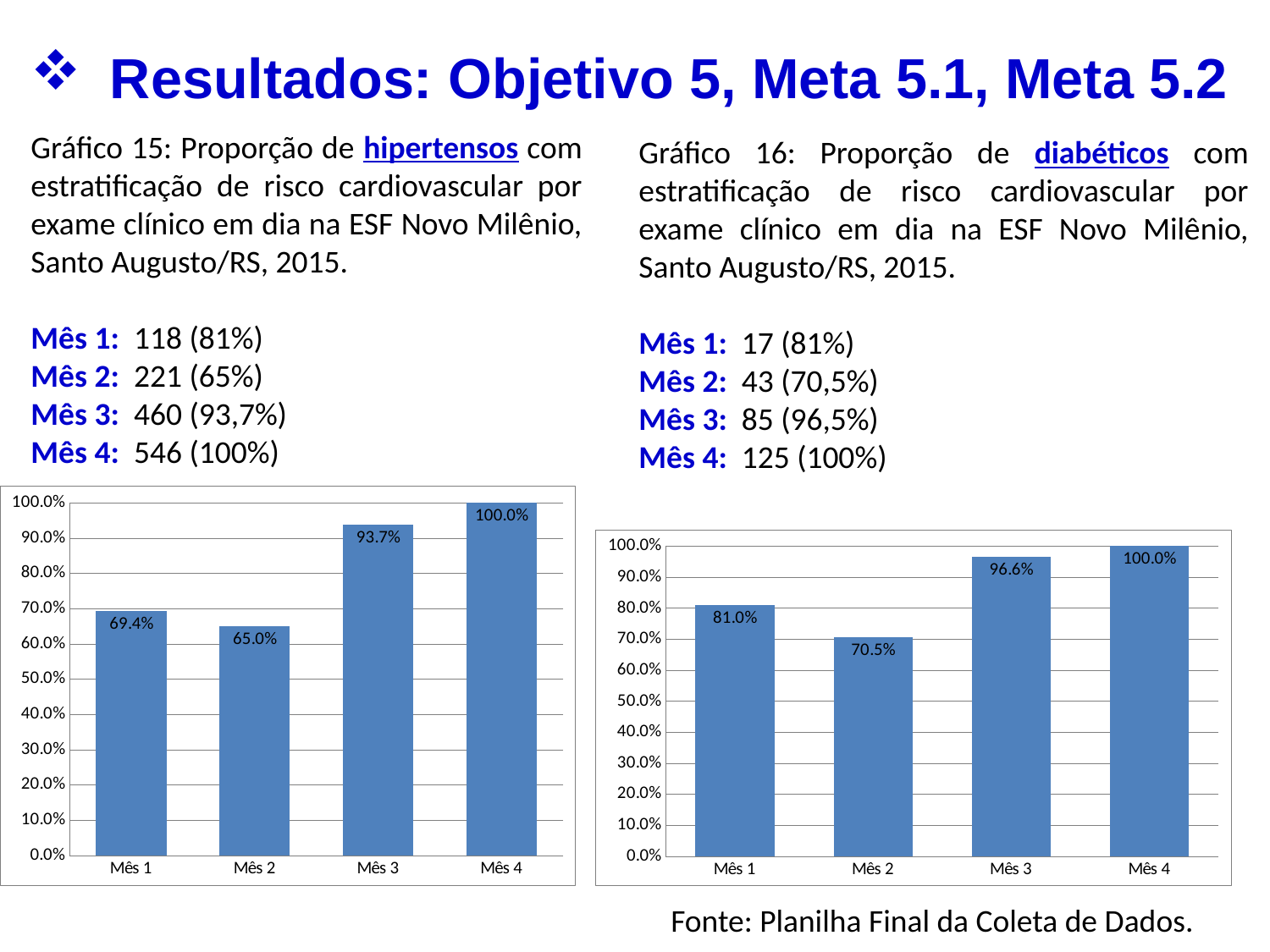
In the right chart (Gráfico 16, diabéticos), which is larger, the value for Mês 1 or the value for Mês 2? Mês 1 In the right chart (Gráfico 16, diabéticos), what is the value for Mês 3? 96.6% In the right chart (Gráfico 16, diabéticos), what is the value for Mês 2? 70.5% In the left chart (Gráfico 15, hipertensos), which month has the lowest value? Mês 2 In the left chart (Gráfico 15, hipertensos), what is the difference between the values for Mês 3 and Mês 2? 28.7% How many bars are plotted in the left chart (Gráfico 15, hipertensos)? 4 In the right chart (Gráfico 16, diabéticos), do the values rise or fall from Mês 2 to Mês 4? Rise In the left chart (Gráfico 15, hipertensos), what is the value for Mês 3? 93.7% In the left chart (Gráfico 15, hipertensos), what is the value for Mês 1? 69.4% In the right chart (Gráfico 16, diabéticos), what is the difference between the values for Mês 1 and Mês 2? 10.5% What type of chart is the right chart (Gráfico 16, diabéticos)? Bar chart In the right chart (Gráfico 16, diabéticos), which month has the highest value? Mês 4